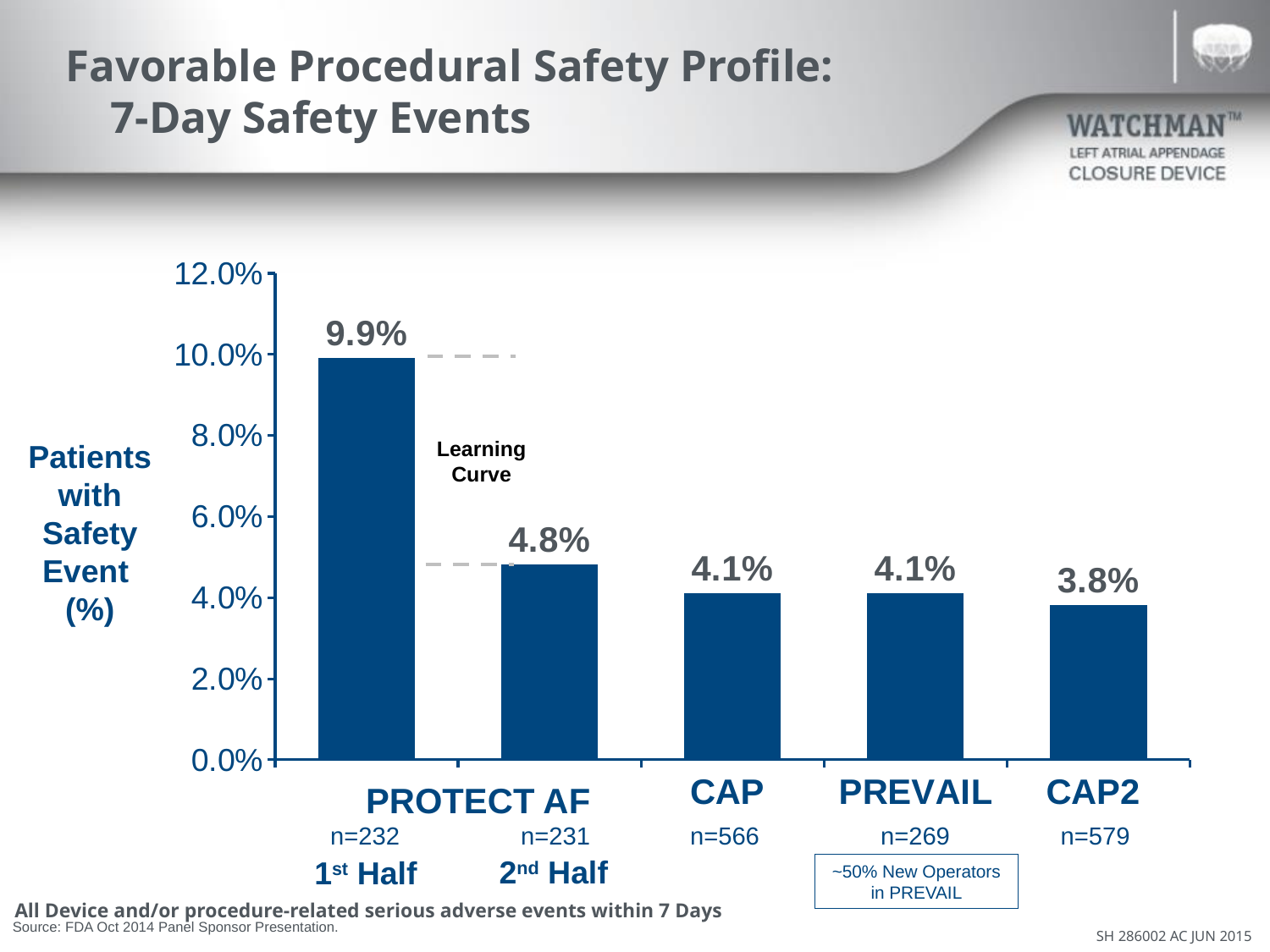
What is the 7-day safety event rate for the PROTECT AF 1st Half? 9.9% Which group has the lowest percentage of patients with a safety event? CAP2 Which group has the highest percentage of patients with a safety event? PROTECT AF 1st Half What is the 7-day safety event rate for PREVAIL? 4.1% Is the safety event rate for the PROTECT AF 1st Half greater or less than 8.0%? greater What is the 7-day safety event rate for the PROTECT AF 2nd Half? 4.8% What is the difference in safety event rate between the PROTECT AF 1st Half and 2nd Half? 5.1% How many bars are plotted in the chart? 5 Which has a higher safety event rate, CAP or CAP2? CAP What is the label on the y-axis of the chart? Patients with Safety Event (%) What type of chart is shown on the slide? Bar chart What is the 7-day safety event rate for CAP2? 3.8%